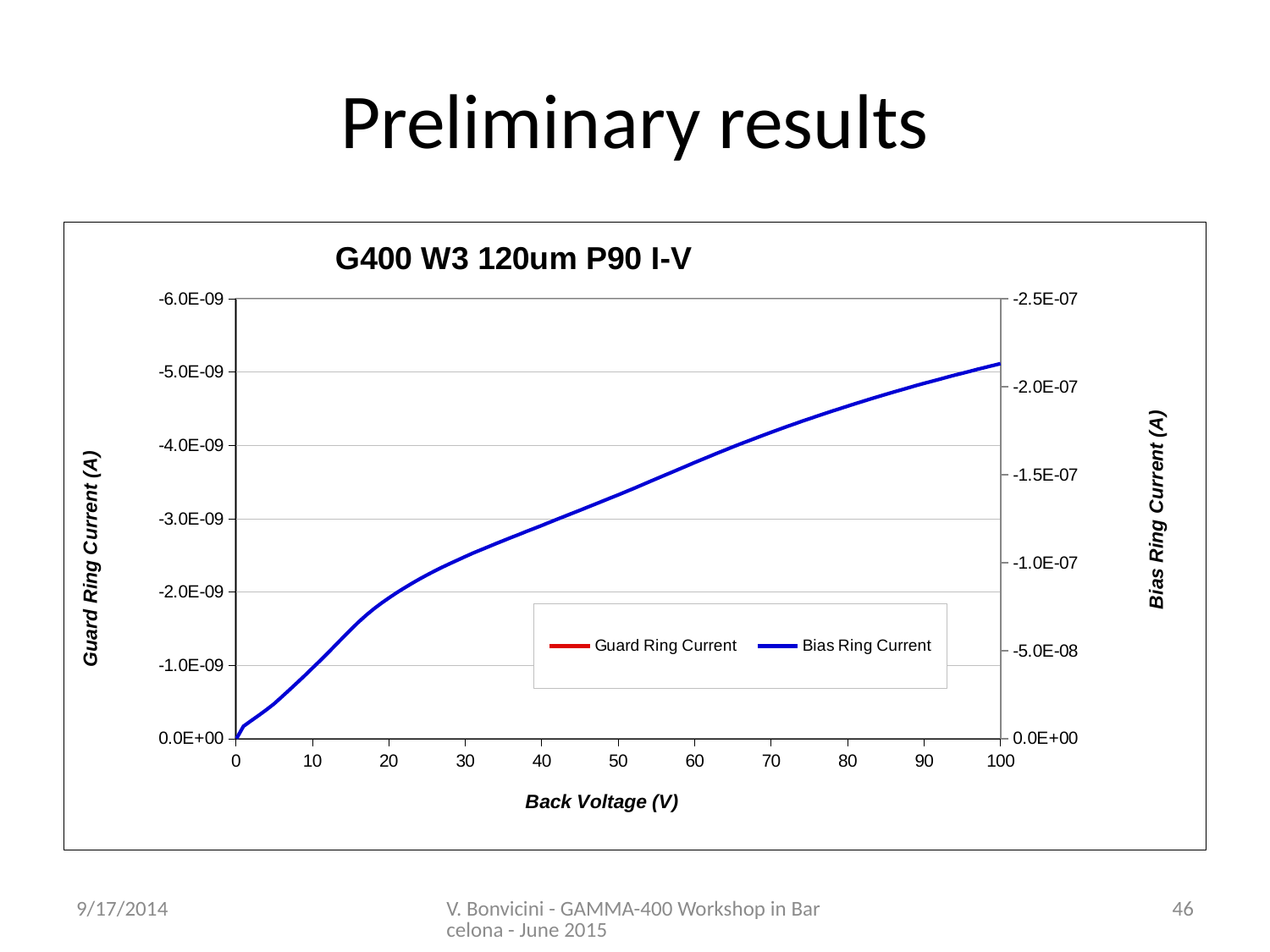
How many labelled tick marks are on the x axis of the chart? 11 What is the maximum value shown on the x axis of the chart? 100 What is the topmost tick value on the left-hand y axis (Guard Ring Current)? -6.0E-09 How many series does the chart legend list? 2 As Back Voltage increases from 0 to 100 V, does the plotted current curve rise or fall on the chart? rises What is the topmost tick value on the right-hand y axis (Bias Ring Current)? -2.5E-07 Is the Bias Ring Current at 100 V greater or less than -2.0E-07 on the right axis? less What kind of chart is shown on the slide? line chart What is the label of the x axis of the chart? Back Voltage (V) What is the title of the chart? G400 W3 120um P90 I-V